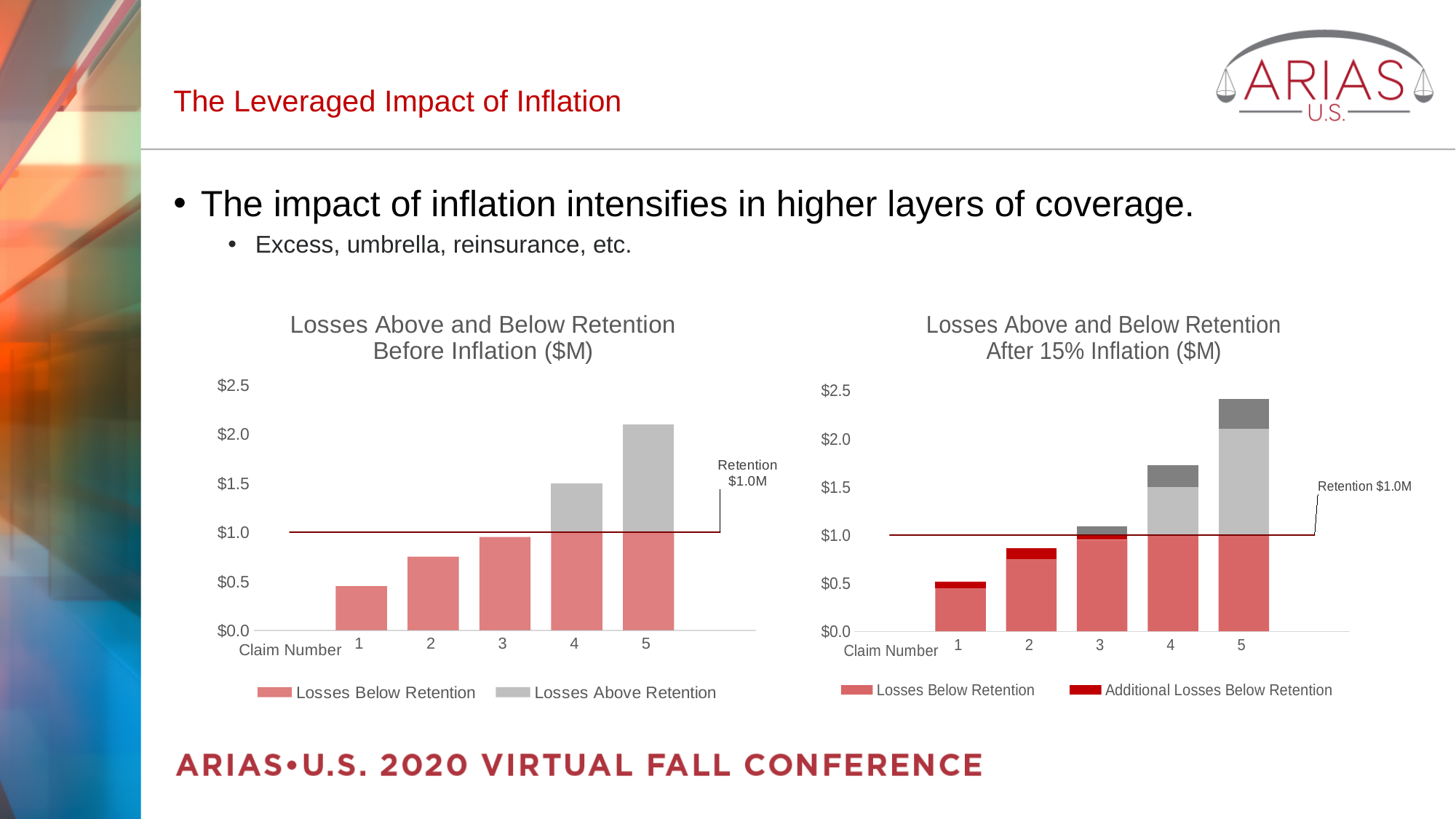
In the right chart (After 15% Inflation), is the total bar for claim 3 greater or less than $1.0? greater In the left chart (Before Inflation), is the total bar for claim 5 greater or less than $2.0? greater In the right chart (After 15% Inflation), is the total bar for claim 2 greater or less than $1.0? less In the left chart (Before Inflation), which claim number has the shortest bar? 1 In the left chart (Before Inflation), how many claim numbers are shown on the x axis? 5 In the right chart (After 15% Inflation), which is taller: the bar for claim 4 or the bar for claim 5? Claim 5 In the left chart (Before Inflation), which claim number has the tallest bar? 5 In the left chart (Before Inflation), do the bar heights rise or fall as the claim number increases from 1 to 5? Rise What retention level is marked by the horizontal line in both charts? Retention $1.0M What kind of chart is the left chart, 'Losses Above and Below Retention Before Inflation ($M)'? Bar chart In the left chart (Before Inflation), how many series does the legend list? 2